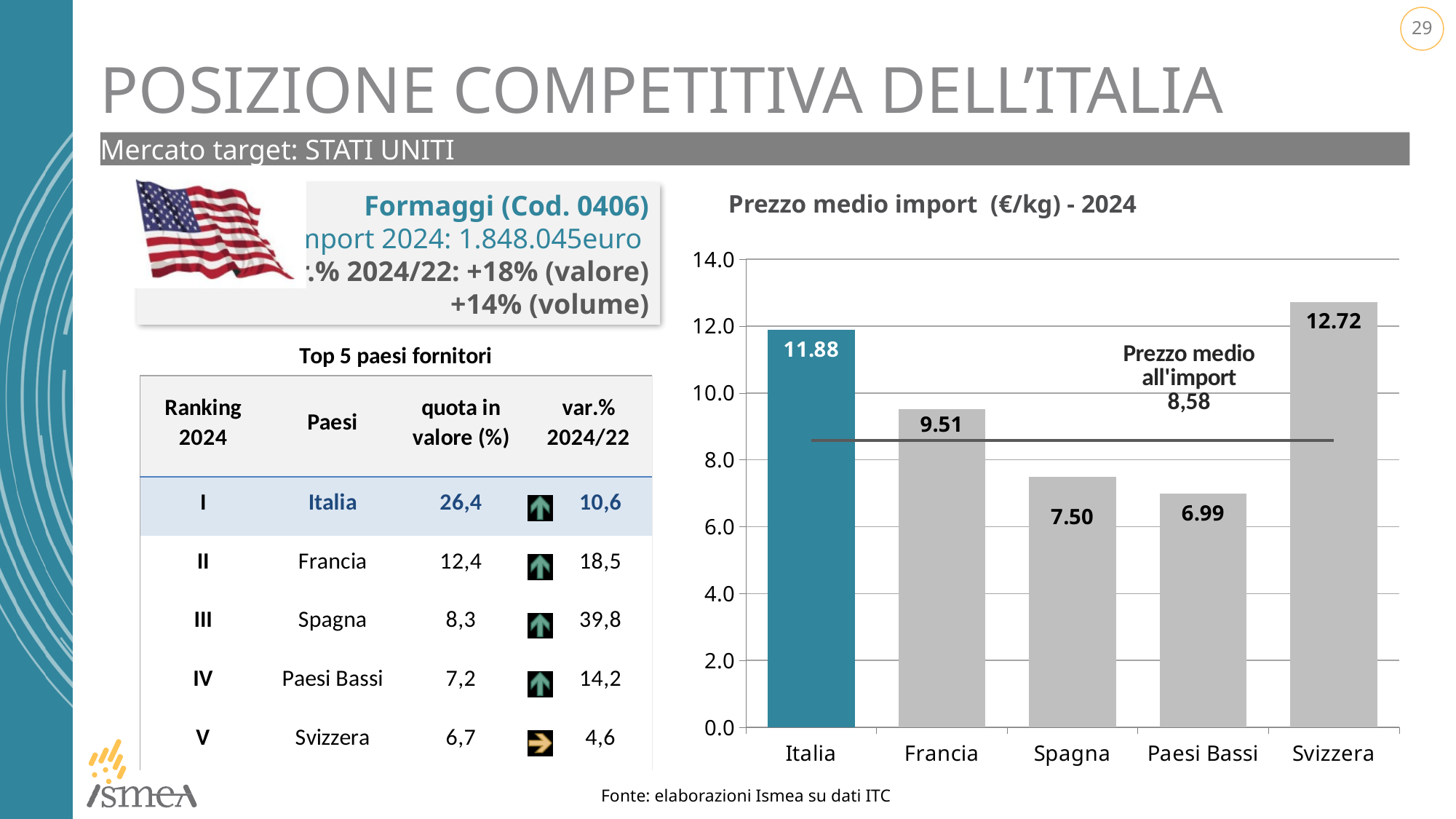
What is the value shown for Paesi Bassi in the chart? 6.99 Is the value for Spagna greater or less than 8.0? less Which country has the lowest average import price in the chart? Paesi Bassi What kind of chart is 'Prezzo medio import (€/kg) - 2024'? bar chart What is the difference between the average import price of Svizzera and Italia? 0.84 What is the difference between the values for Francia and Spagna in the chart? 2.01 What is the average import price for Svizzera in the chart? 12.72 What is the average import price for Italia in the chart 'Prezzo medio import (€/kg) - 2024'? 11.88 How many countries are shown in the chart? 5 Which has a higher average import price, Francia or Spagna? Francia What is the overall average import price ('Prezzo medio all'import') indicated by the horizontal line in the chart? 8,58 Which country has the highest average import price in the chart? Svizzera